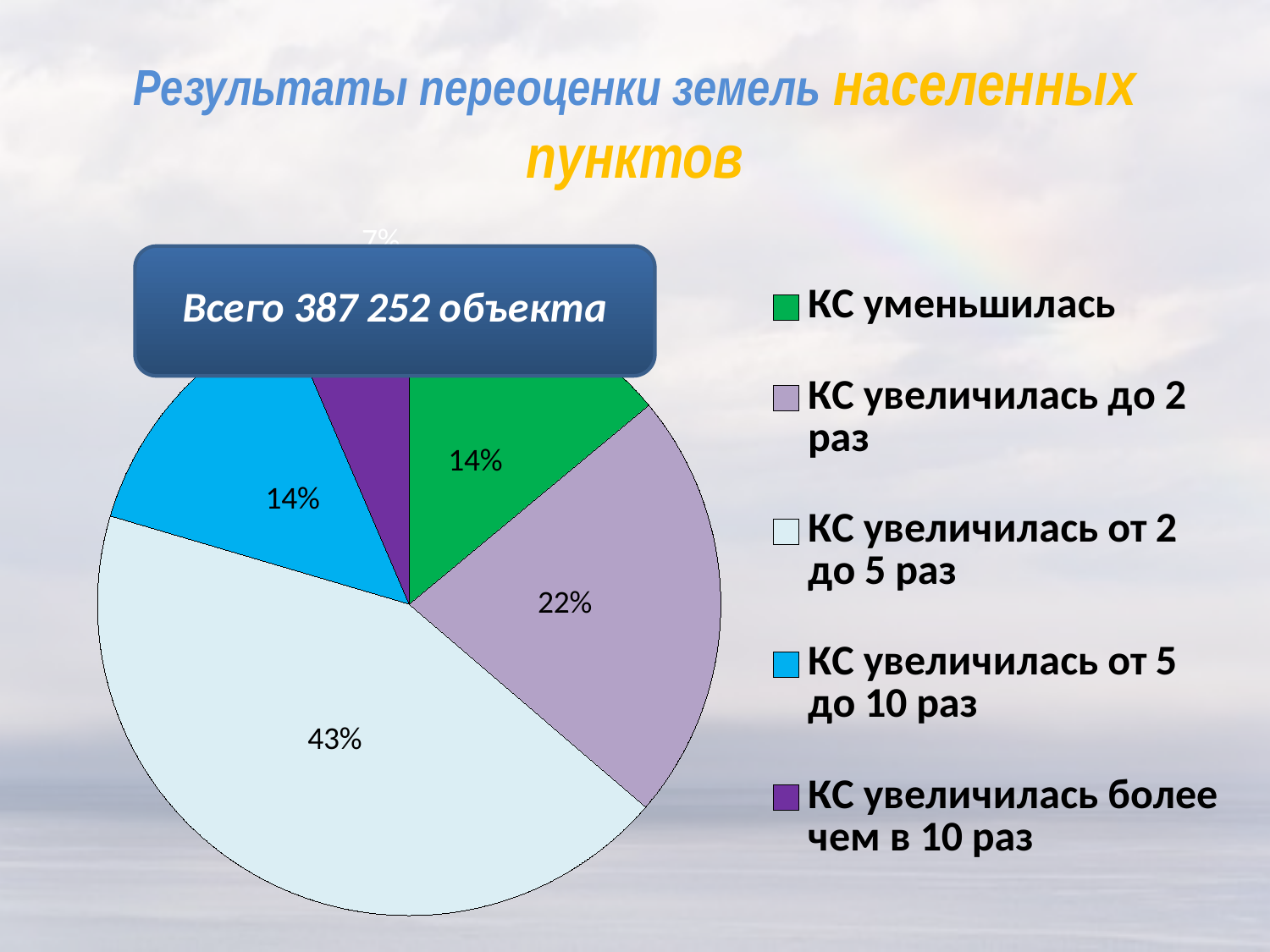
Which category has the smallest slice of the pie? КС увеличилась более чем в 10 раз What is the difference between the shares of "КС увеличилась от 2 до 5 раз" and "КС увеличилась до 2 раз"? 21 percentage points What is the value shown for "КС увеличилась от 5 до 10 раз"? 14% Which category has the largest slice of the pie? КС увеличилась от 2 до 5 раз According to the box on the slide, how many objects in total were revalued? 387 252 What colour is the slice for "КС уменьшилась"? green What share of the pie does "КС увеличилась от 2 до 5 раз" have? 43% Which is larger: the share for "КС увеличилась до 2 раз" or for "КС уменьшилась"? КС увеличилась до 2 раз How many categories does the pie chart have? 5 What kind of chart is shown on the slide? pie chart What share of the pie does "КС увеличилась до 2 раз" have? 22% What is the value shown for "КС уменьшилась"? 14%